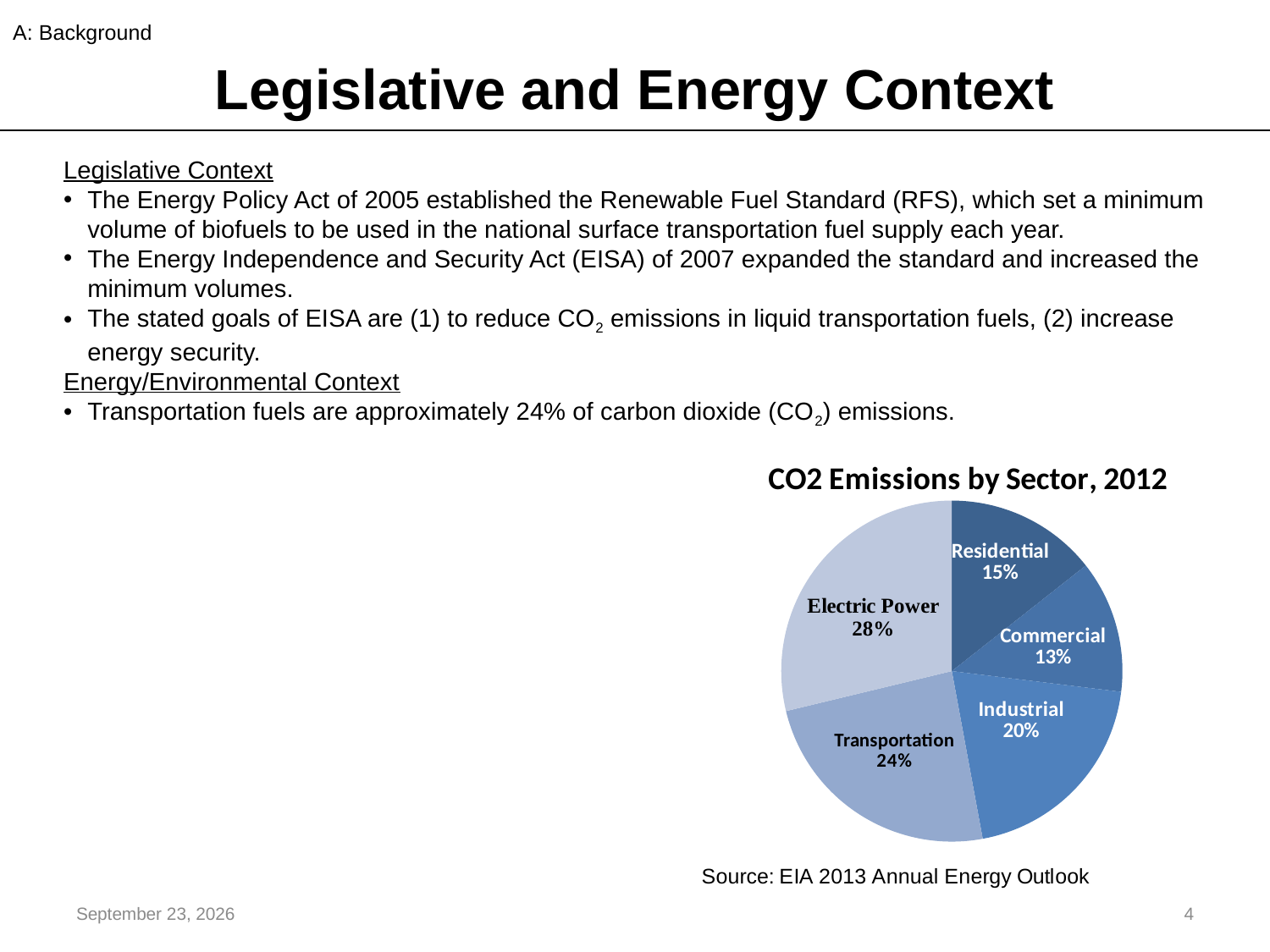
Which sector has the largest share of CO2 emissions? Electric Power Which sector has the smallest share of CO2 emissions? Commercial What is the combined share of the Transportation and Industrial sectors? 44% What kind of chart is shown on the slide? pie chart What share of CO2 emissions does the Residential sector account for? 15% What is the title of the chart? CO2 Emissions by Sector, 2012 Which sector has a larger share, Industrial or Residential? Industrial What share of CO2 emissions does the Electric Power sector account for? 28% What share of CO2 emissions does the Transportation sector account for? 24% What share of CO2 emissions does the Industrial sector account for? 20% What is the difference in percentage points between the Electric Power and Commercial shares? 15 How many sectors are shown in the pie chart? 5